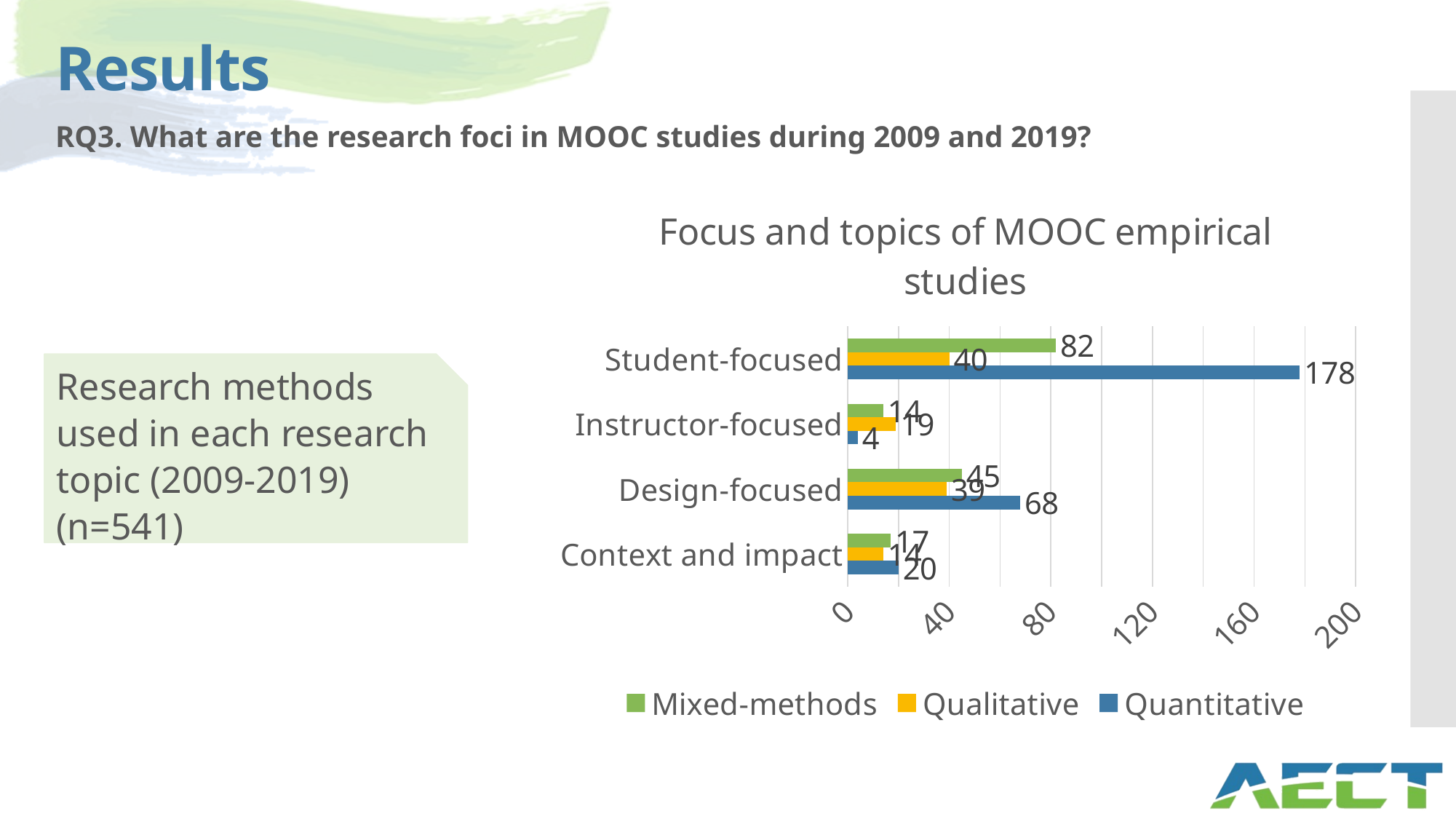
What is the Qualitative value for Instructor-focused? 19 What is the Mixed-methods value for Design-focused? 45 What is the difference between the Quantitative and Mixed-methods values for Student-focused? 96 For Design-focused, which is larger: the Quantitative value or the Mixed-methods value? Quantitative Which category has the lowest Quantitative value? Instructor-focused What is the difference between the Quantitative and Qualitative values for Design-focused? 29 What is the Quantitative value for Instructor-focused? 4 How many categories are shown on the chart? 4 Is the Quantitative value for Student-focused greater or less than 160? greater Which category has the highest Quantitative value? Student-focused How many series does the legend list? 3 What is the Quantitative value for Student-focused? 178